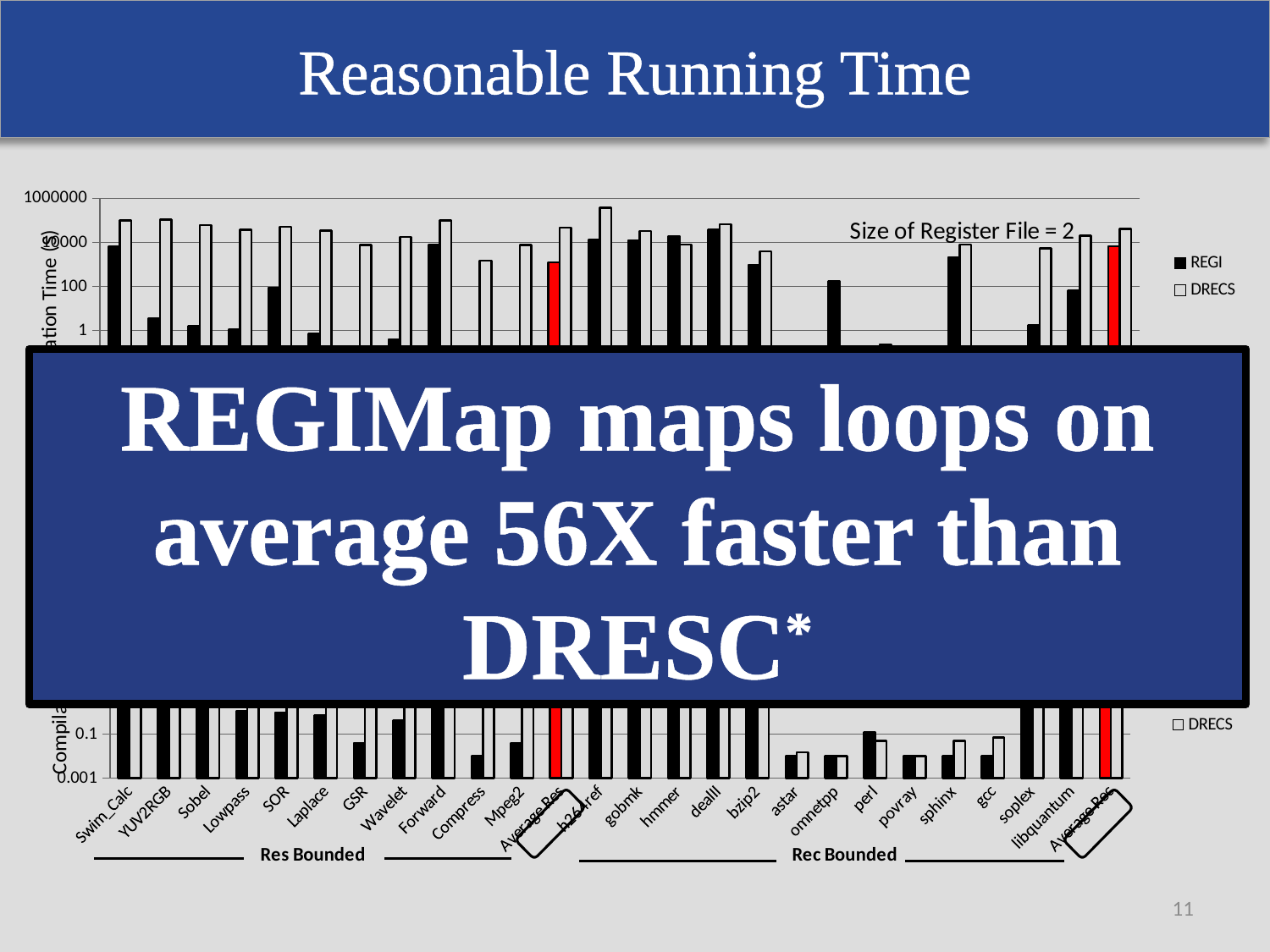
In the top chart, how many series does the legend list? 2 What kind of chart is shown on the slide? bar chart In the top chart, is the REGI value for Sobel greater or less than 100? less In the top chart, is the DRECS value for Swim_Calc greater or less than 10000? greater How many benchmark categories are labelled along the x axis? 26 In the top chart, which is larger for Swim_Calc, the REGI value or the DRECS value? DRECS In the top chart, is the REGI value for YUV2RGB greater or less than 100? less In the top chart, what are the two series named in the legend? REGI and DRECS What annotation about the register file size appears in the top chart? Size of Register File = 2 In the top chart, which is larger for Lowpass, the REGI value or the DRECS value? DRECS In the top chart, which category has the tallest DRECS bar? h264ref